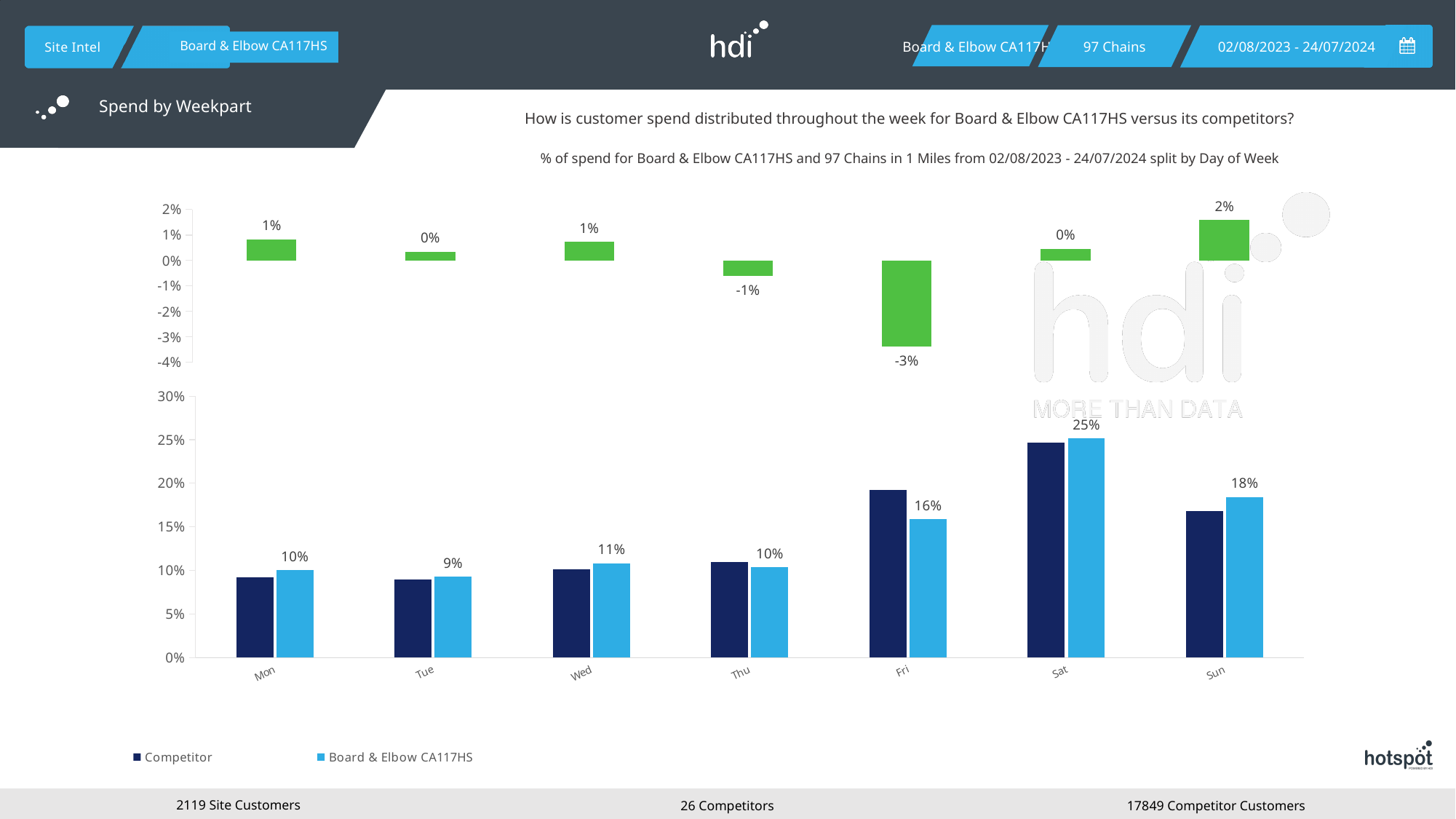
In the bottom chart, on which day is the Board & Elbow CA117HS value highest? Sat In the top chart, which day has the highest value? Sun In the top chart, what is the value shown for Fri? -3% How many series does the legend of the bottom chart list? 2 In the bottom chart, what is the value for Board & Elbow CA117HS on Sat? 25% In the bottom chart, which is larger on Fri: the Competitor value or the Board & Elbow CA117HS value? Competitor In the bottom chart, what is the difference between the Board & Elbow CA117HS values for Sat and Sun? 7% How many days of the week are shown on the x axis of the bottom chart? 7 In the bottom chart, on which day is the Board & Elbow CA117HS value lowest? Tue In the bottom chart, is the Competitor value for Fri greater or less than 15%? greater What kind of chart is the bottom chart? Bar chart In the bottom chart, what is the value for Board & Elbow CA117HS on Wed? 11%